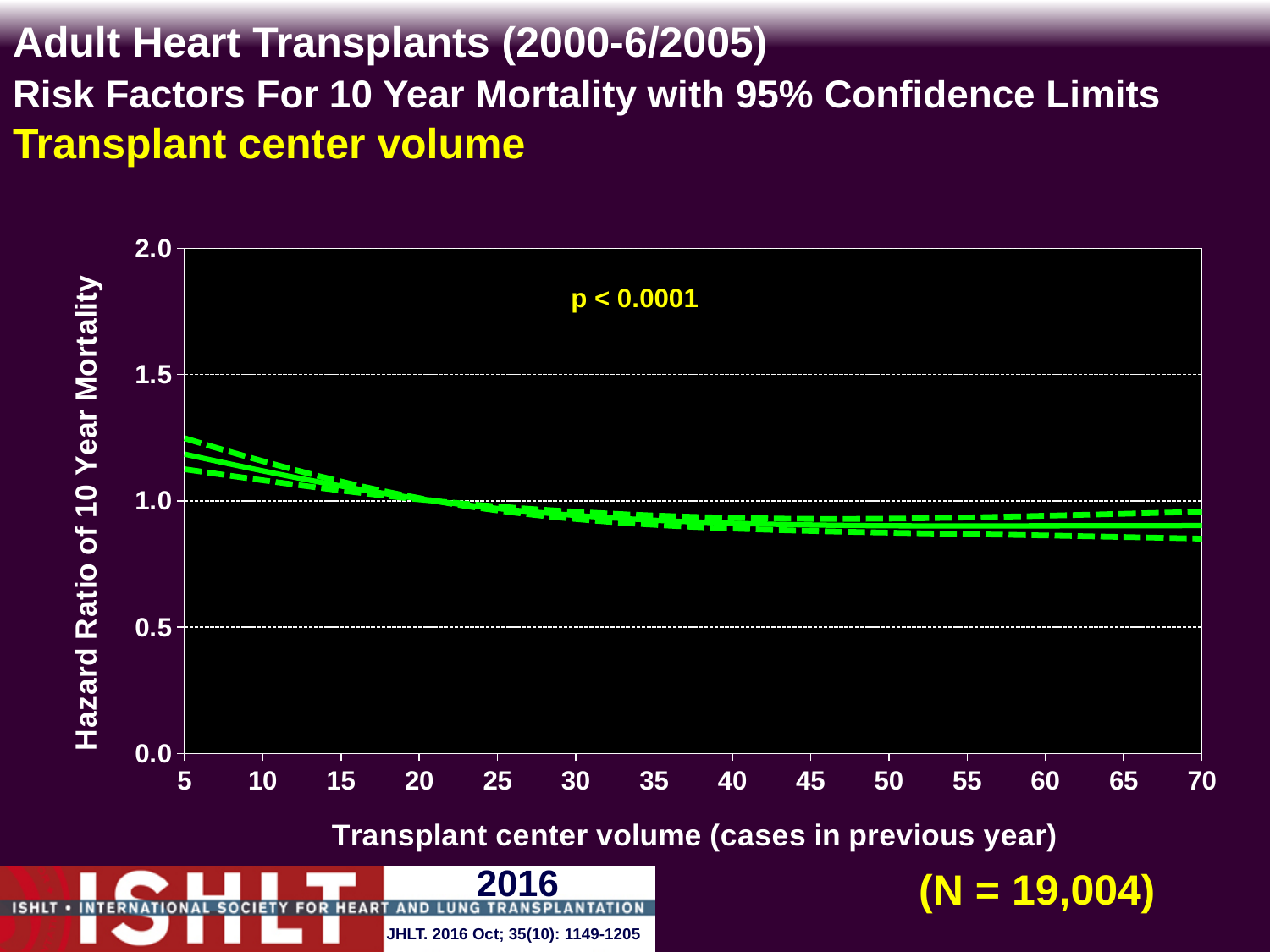
Is the hazard ratio for a transplant center volume of 40 greater or less than 1.0? less How many tick labels are shown on the x axis? 14 Is the hazard ratio for a transplant center volume of 70 greater or less than 1.0? less What is the label of the x axis? Transplant center volume (cases in previous year) Which transplant center volume has the higher hazard ratio, 5 or 70? 5 What kind of chart is shown on the slide? line chart Is the upper 95% confidence limit at a transplant center volume of 5 greater or less than 1.5? less How many lines are plotted on the chart? 3 What p-value is printed on the chart? p < 0.0001 How does the hazard ratio of 10 year mortality change as transplant center volume increases along the x axis? it falls At which transplant center volume shown on the x axis is the hazard ratio highest? 5